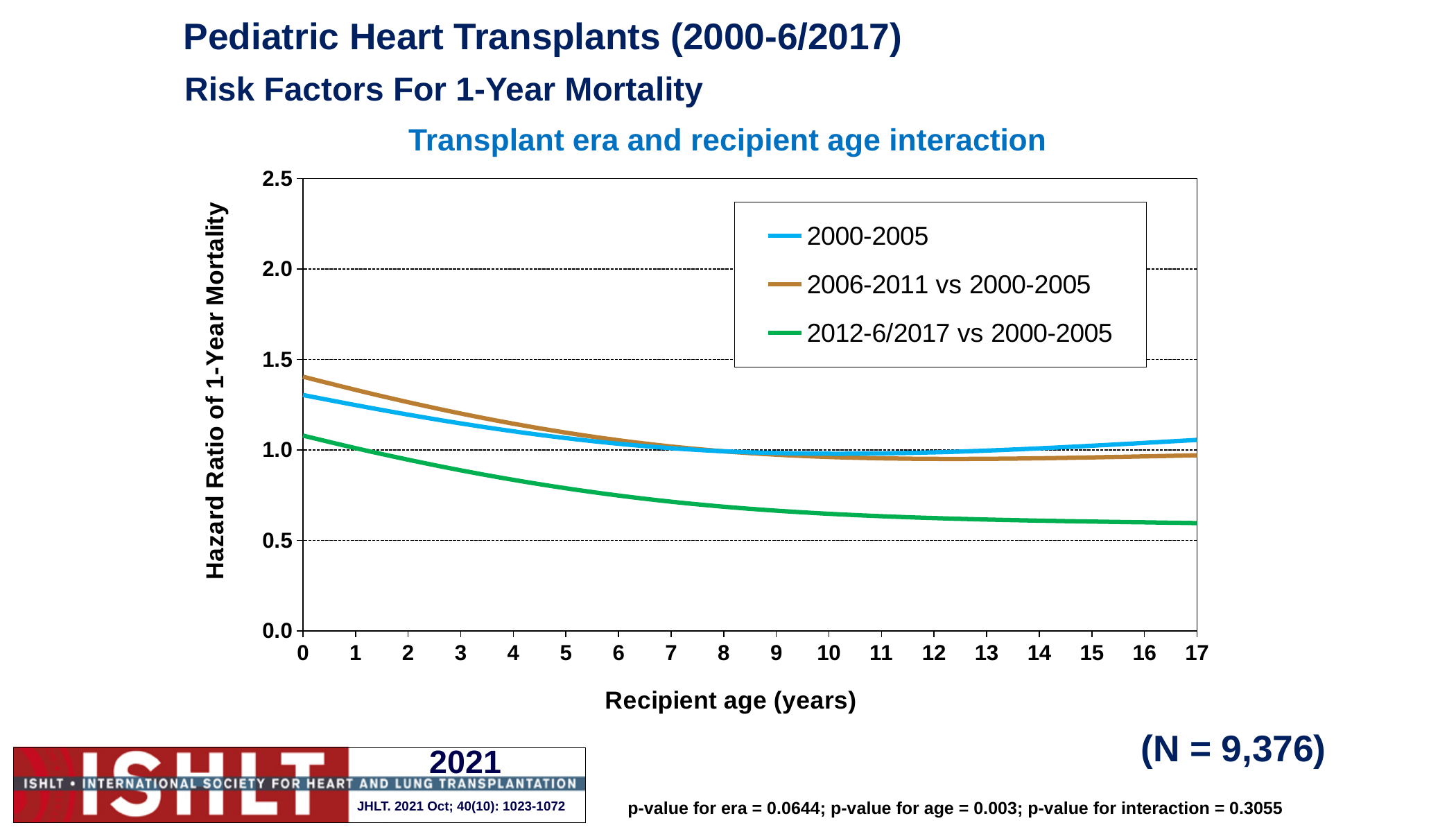
Is the hazard ratio for the 2006-2011 vs 2000-2005 series at recipient age 0 greater or less than 1.0? greater What is the label of the y axis? Hazard Ratio of 1-Year Mortality Which series has the lowest hazard ratio at recipient age 17? 2012-6/2017 vs 2000-2005 Which series has the highest hazard ratio at recipient age 0? 2006-2011 vs 2000-2005 At recipient age 0, which series has the larger hazard ratio: 2000-2005 or 2006-2011 vs 2000-2005? 2006-2011 vs 2000-2005 Is the hazard ratio for the 2012-6/2017 vs 2000-2005 series at recipient age 10 greater or less than 0.5? greater Does the hazard ratio for the 2012-6/2017 vs 2000-2005 series rise or fall as recipient age increases from 0 to 17? fall What kind of chart is shown on the slide? Line chart At recipient age 5, which series has the larger hazard ratio: 2000-2005 or 2012-6/2017 vs 2000-2005? 2000-2005 Is the hazard ratio for the 2012-6/2017 vs 2000-2005 series at recipient age 17 greater or less than 1.0? less How many series does the legend list? 3 Which series is plotted with the green line? 2012-6/2017 vs 2000-2005